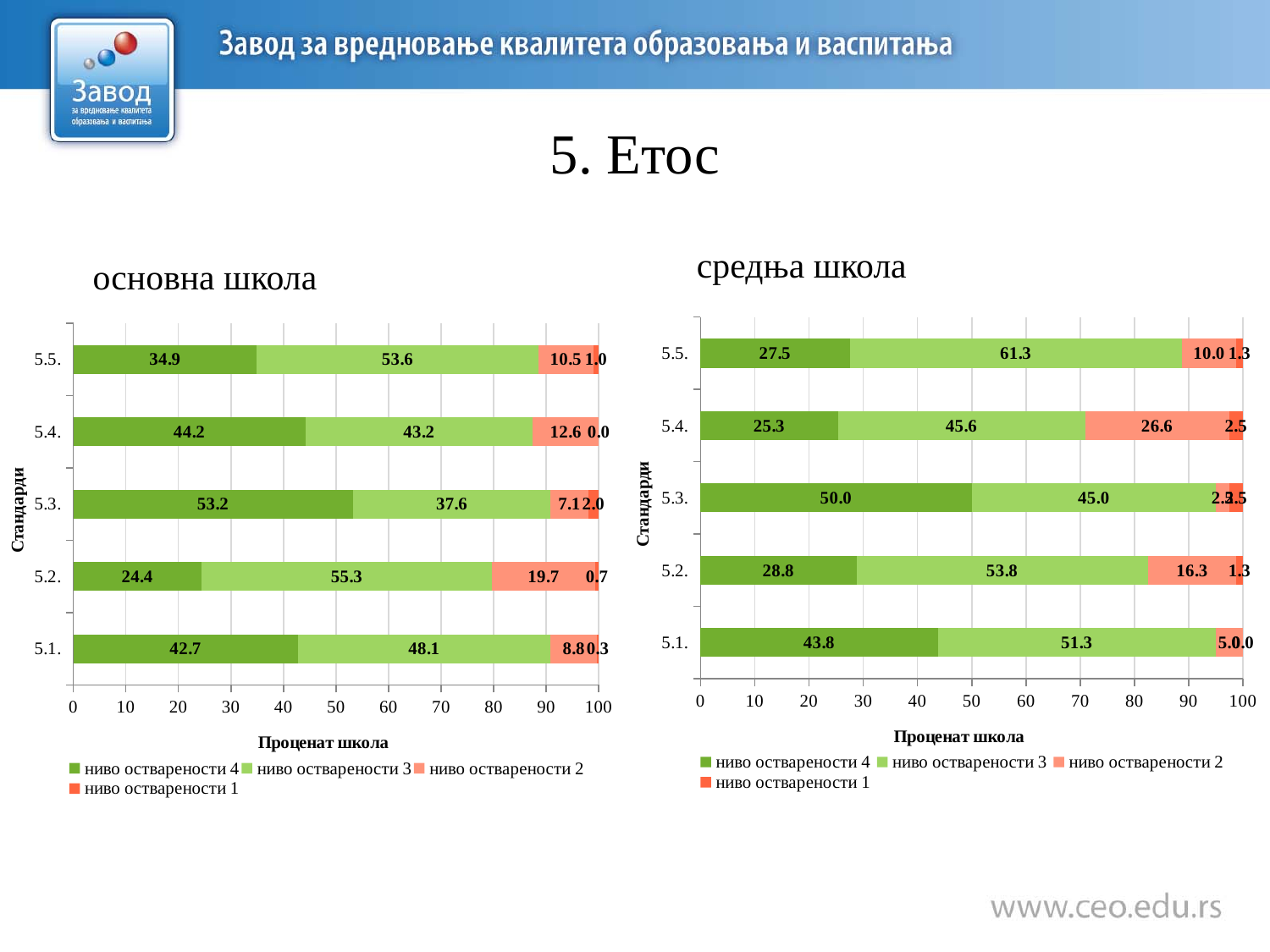
In the основна школа chart, what is the value of ниво остварености 2 for standard 5.4.? 12.6 How many series does the legend of the средња школа chart list? 4 In the основна школа chart, which standard has the highest value for ниво остварености 4? 5.3. In the средња школа chart, is ниво остварености 4 larger for standard 5.1. or for standard 5.2.? 5.1. In the основна школа chart, what is the difference between ниво остварености 4 for standard 5.4. and for standard 5.5.? 9.3 In the средња школа chart, what is the value of ниво остварености 2 for standard 5.4.? 26.6 In the основна школа chart, what is the value of ниво остварености 4 for standard 5.3.? 53.2 What type of chart is the основна школа chart? Stacked bar chart In the средња школа chart, which standard has the highest value for ниво остварености 2? 5.4. In the средња школа chart, what is the value of ниво остварености 3 for standard 5.5.? 61.3 In the основна школа chart, which standard has the lowest value for ниво остварености 4? 5.2. In the основна школа chart, what is the value of ниво остварености 3 for standard 5.2.? 55.3